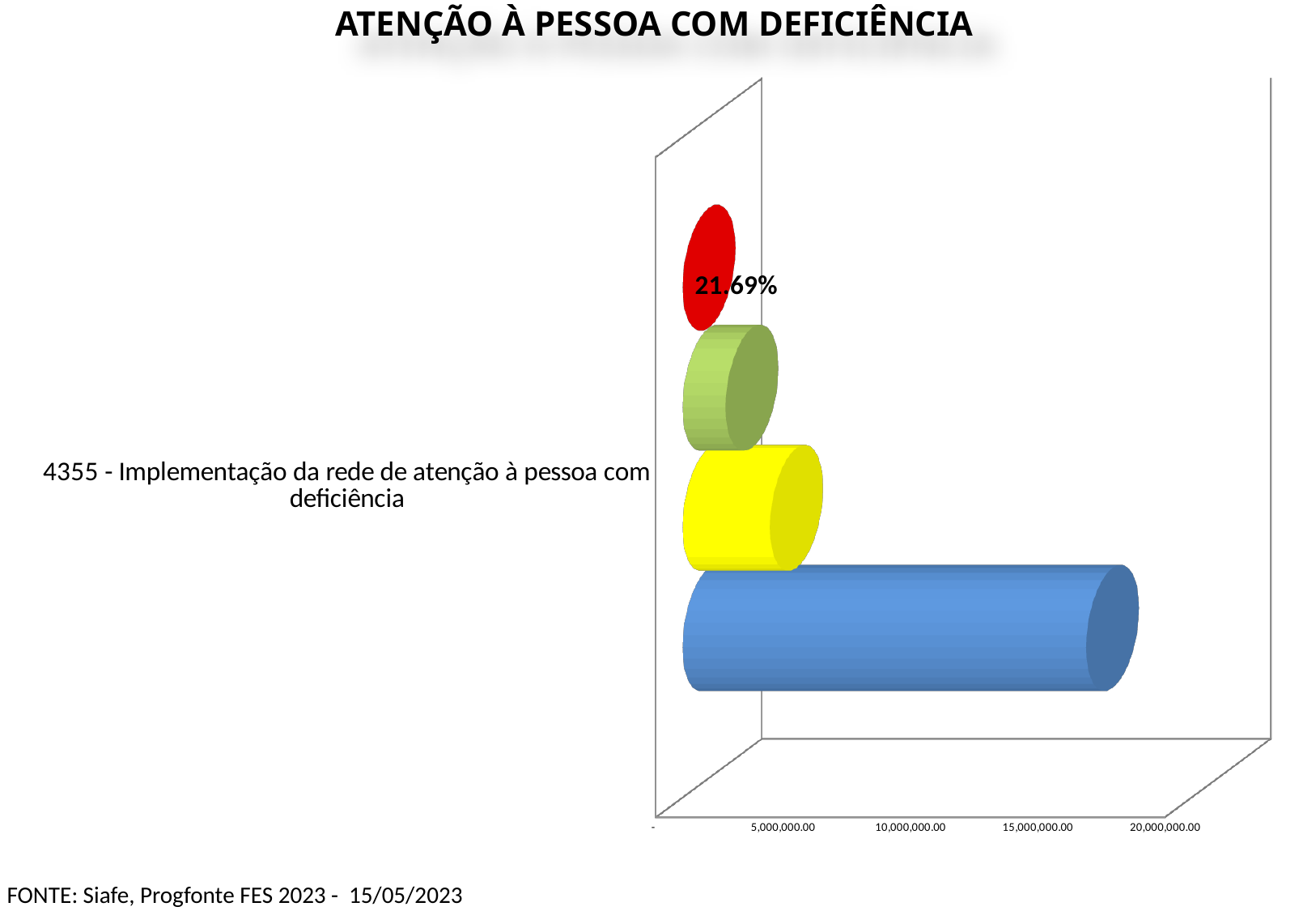
Which is larger, the value of the blue bar or the value of the yellow bar? the blue bar Which coloured bar is the longest on the chart? the blue bar How many bars are plotted for the category '4355 - Implementação da rede de atenção à pessoa com deficiência'? 4 Is the value of the red bar greater or less than 5,000,000.00? less How many categories are shown on the vertical axis of the chart? 1 Is the value of the blue bar greater or less than 15,000,000.00? greater Is the value of the green bar greater or less than 10,000,000.00? less What is the category label shown on the chart? 4355 - Implementação da rede de atenção à pessoa com deficiência What is the title of the chart? ATENÇÃO À PESSOA COM DEFICIÊNCIA What kind of chart is shown on the slide? bar chart Which coloured bar is the shortest on the chart? the red bar What percentage value is printed as a data label on the chart? 21.69%